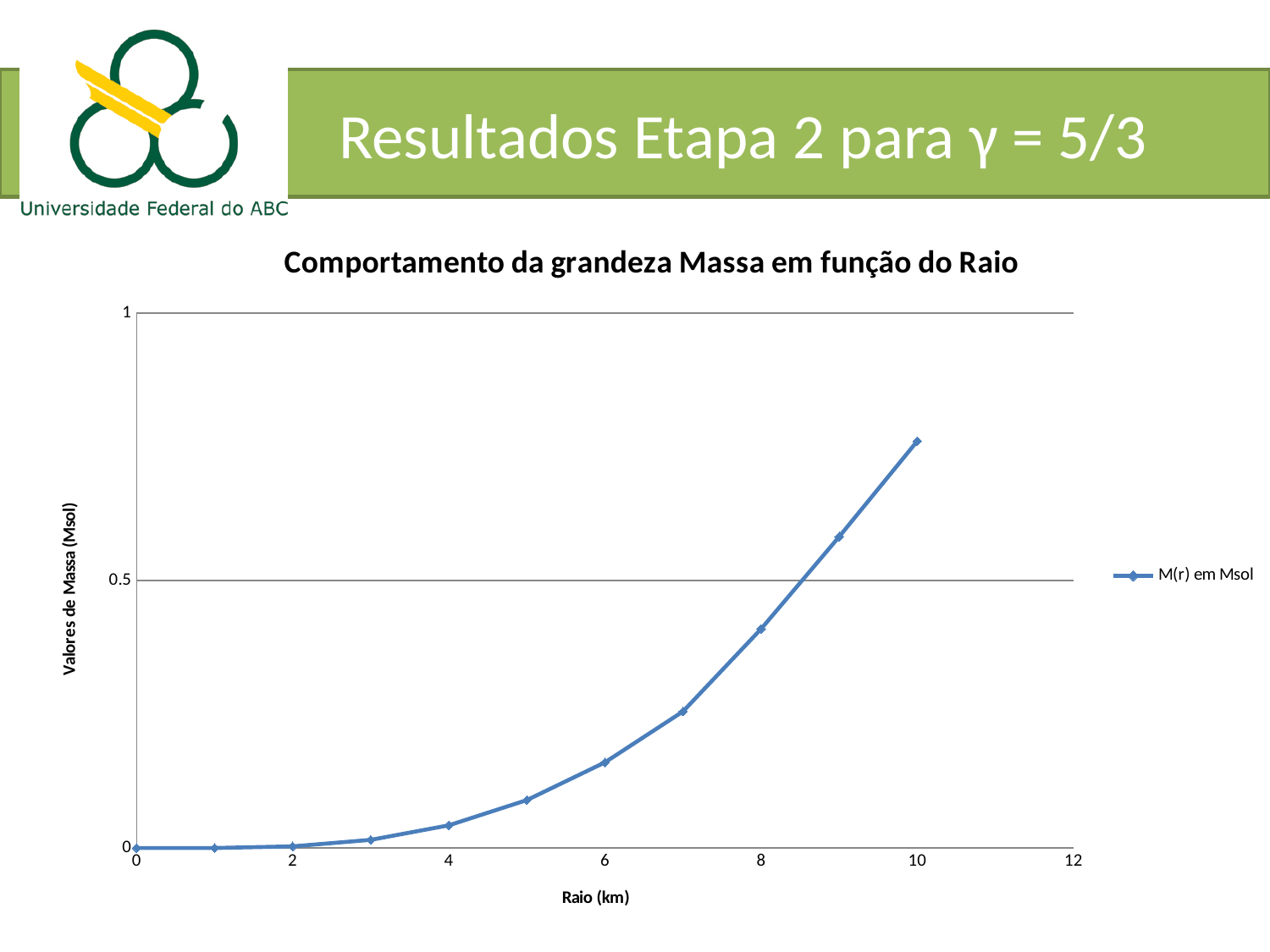
What is the title of the chart? Comportamento da grandeza Massa em função do Raio Is the value of M(r) at Raio = 10 km greater or less than 0.5? greater At which value of Raio (km) is M(r) highest? 10 Which is larger, the value of M(r) at Raio = 6 km or at Raio = 8 km? Raio = 8 km How many data points are plotted on the line? 11 What is the label of the x axis? Raio (km) How many series does the legend list? 1 Is the value of M(r) at Raio = 8 km greater or less than 0.5? less Is the value of M(r) at Raio = 9 km greater or less than 0.5? greater What is the name of the series shown in the legend? M(r) em Msol Do the values of M(r) rise or fall as Raio increases along the x axis? rise What kind of chart is shown on the slide? line chart